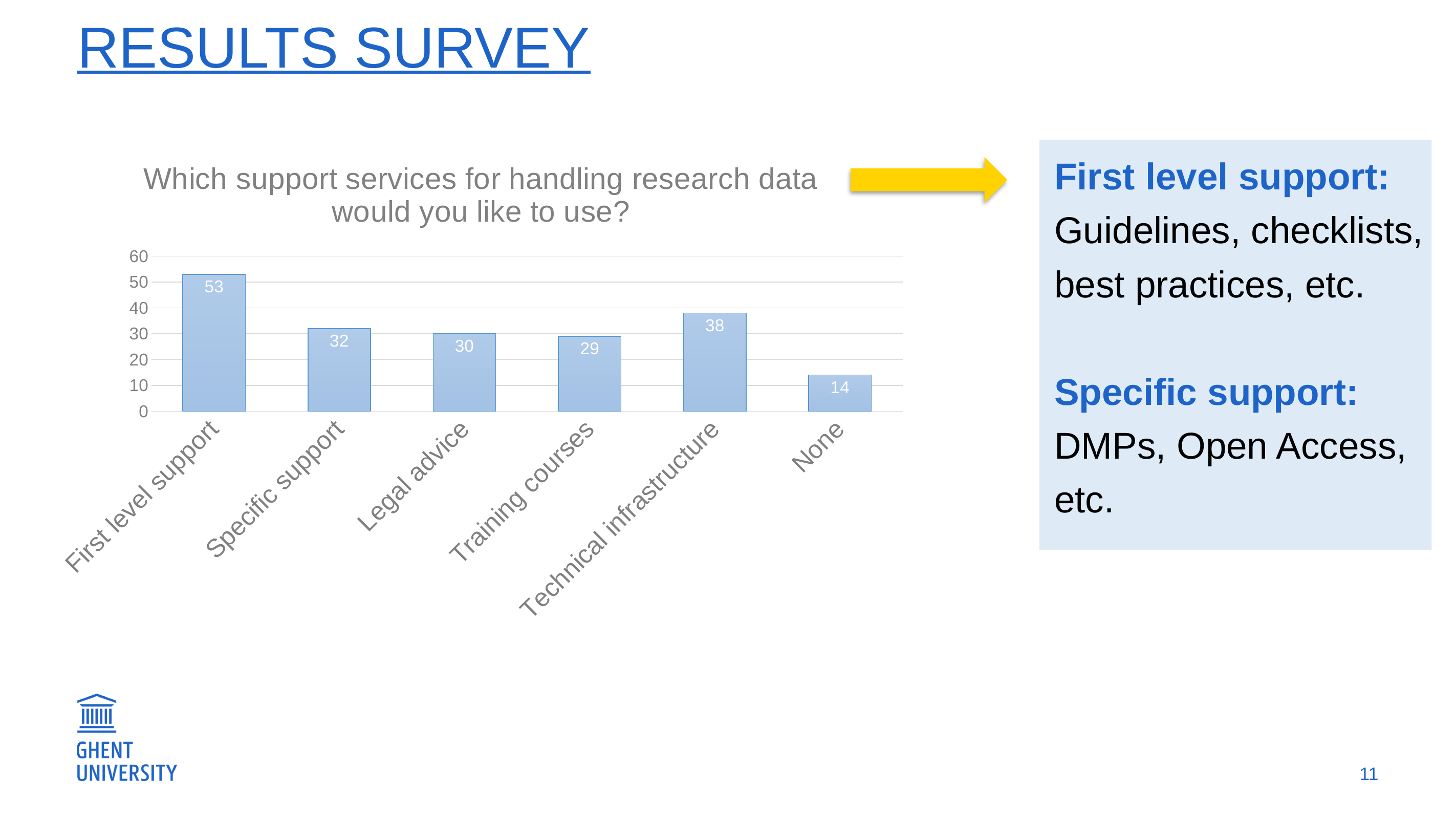
What kind of chart is shown? Bar chart Which is larger, Technical infrastructure or Legal advice? Technical infrastructure What is the value for Training courses? 29 How many categories are shown on the x axis? 6 What is the difference between Technical infrastructure and None? 24 Which category has the lowest value? None What is the value for First level support? 53 Which category has the highest value? First level support What is the value for Technical infrastructure? 38 What is the value for None? 14 What is the title of the chart? Which support services for handling research data would you like to use? What is the difference between First level support and Specific support? 21